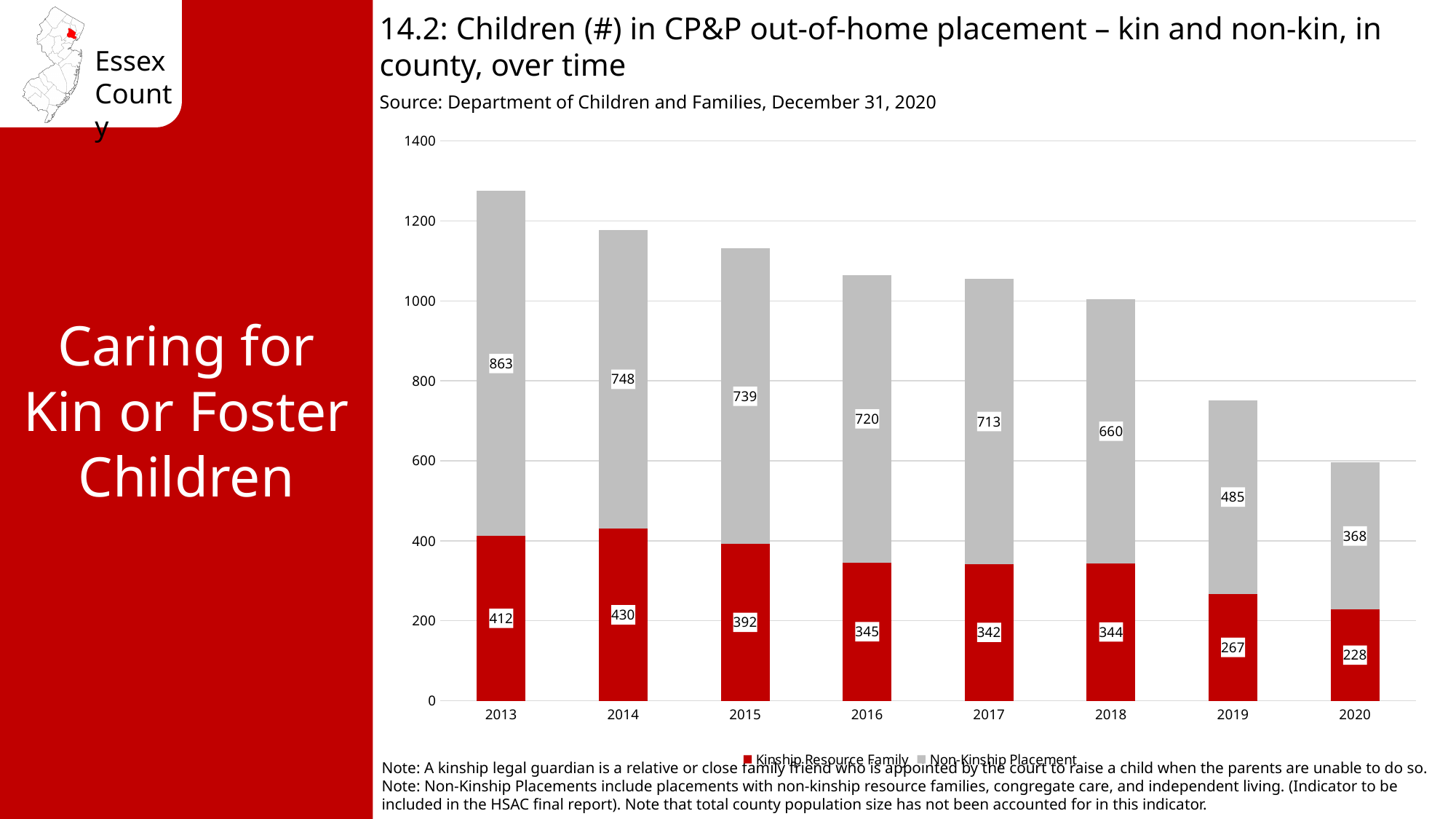
Which is larger, the Kinship Resource Family value for 2015 or for 2019? 2015 How many years are shown on the x axis? 8 What is the Kinship Resource Family value for 2014? 430 What is the total of the stacked bar for 2019? 752 What is the difference between the Non-Kinship Placement values for 2013 and 2020? 495 Do the Non-Kinship Placement values rise or fall from 2013 to 2020? fall Which year has the highest Non-Kinship Placement value? 2013 Is the total of the stacked bar for 2013 greater or less than 1200? greater What is the Non-Kinship Placement value for 2018? 660 Which year has the lowest Kinship Resource Family value? 2020 What kind of chart is shown on the slide? Stacked bar chart How many series does the legend list? 2